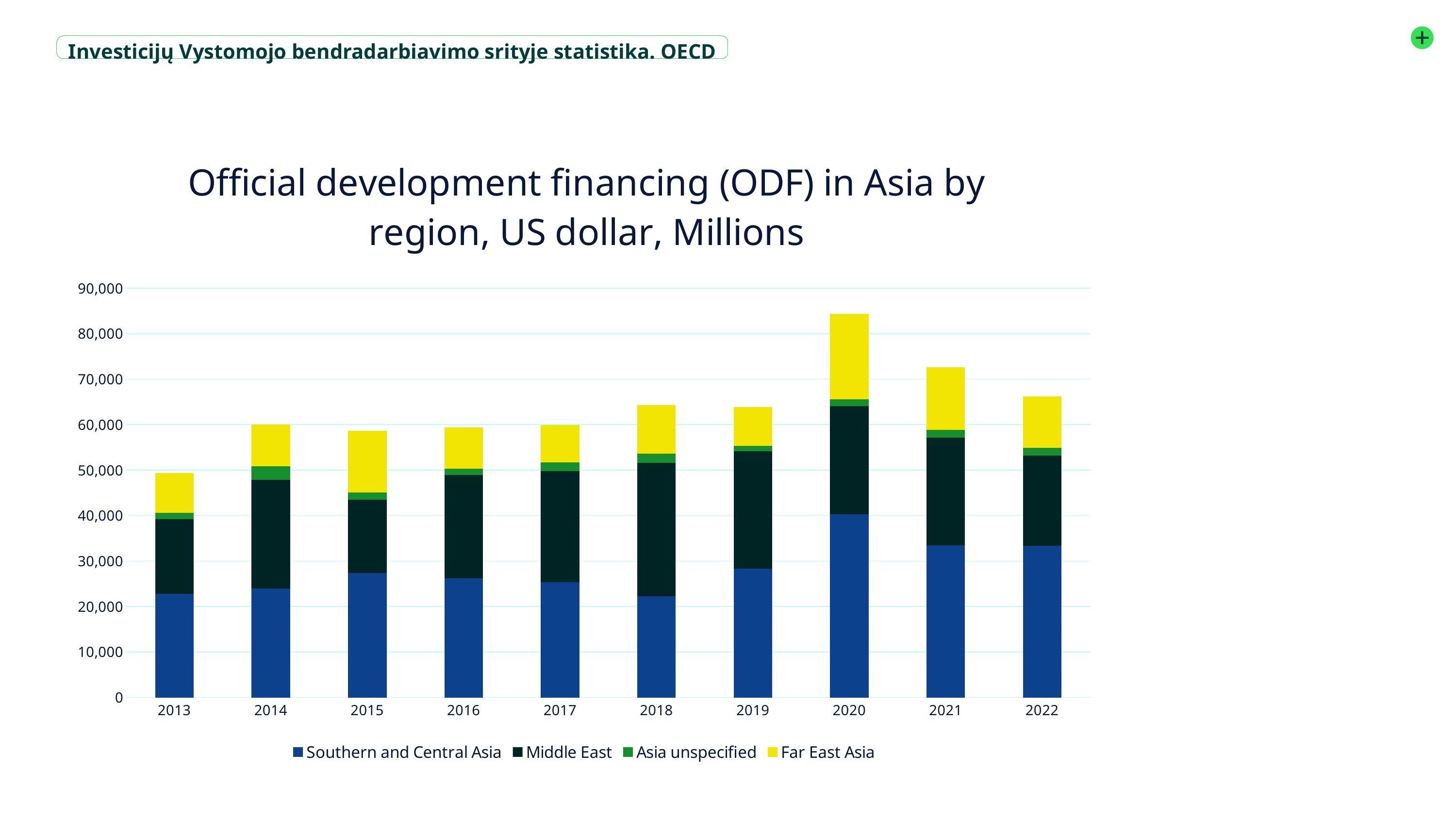
Is the Southern and Central Asia value for 2020 greater or less than 30,000? greater Is the total value for 2020 greater or less than 80,000? greater Which series is shown in yellow in the legend? Far East Asia Which year has the lowest total official development financing? 2013 Is the total value for 2021 greater or less than 70,000? greater Which total is larger, 2020 or 2021? 2020 How many series does the legend list? 4 How many years are shown on the x axis of the chart? 10 Which year has the largest Southern and Central Asia segment? 2020 What kind of chart is shown on the slide? Stacked bar chart Which year has the highest total official development financing? 2020